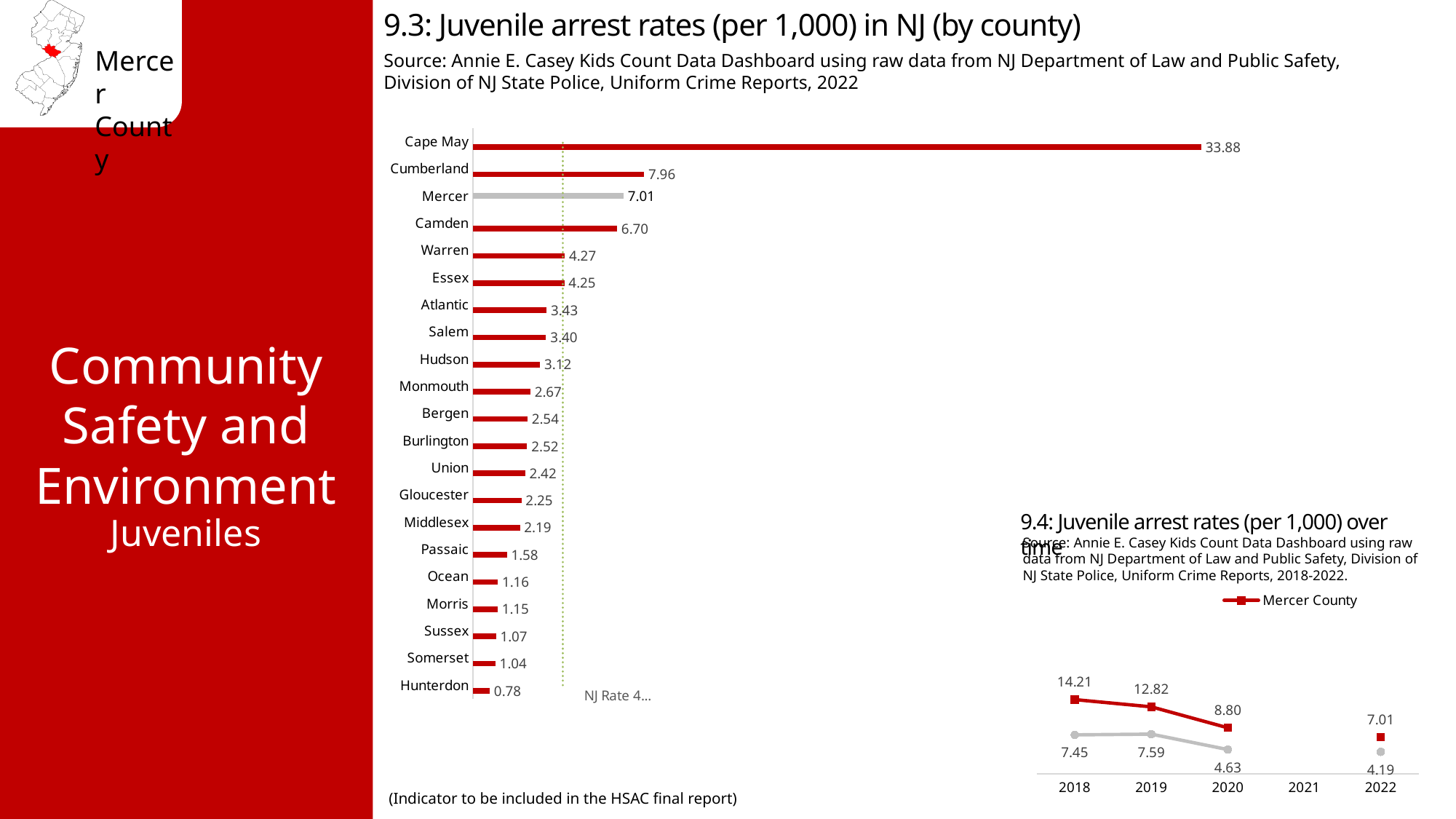
In chart 9.4 (Juvenile arrest rates over time), what is the Mercer County value for 2018? 14.21 In chart 9.3 (Juvenile arrest rates by county), which county has the lowest juvenile arrest rate? Hunterdon In chart 9.3 (Juvenile arrest rates by county), how many counties are shown? 21 In chart 9.4 (Juvenile arrest rates over time), does the Mercer County rate rise or fall from 2018 to 2020? Fall In chart 9.4 (Juvenile arrest rates over time), what is the difference between the Mercer County values for 2019 and 2020? 4.02 What kind of chart is chart 9.3 (Juvenile arrest rates by county)? Bar chart In chart 9.3 (Juvenile arrest rates by county), what is the juvenile arrest rate for Mercer? 7.01 In chart 9.3 (Juvenile arrest rates by county), what is the value for Cumberland? 7.96 In chart 9.3 (Juvenile arrest rates by county), which has a higher rate, Camden or Warren? Camden In chart 9.3 (Juvenile arrest rates by county), which county has the highest juvenile arrest rate? Cape May In chart 9.3 (Juvenile arrest rates by county), what is the difference between the rates for Cape May and Cumberland? 25.92 In chart 9.4 (Juvenile arrest rates over time), what is the Mercer County value for 2022? 7.01